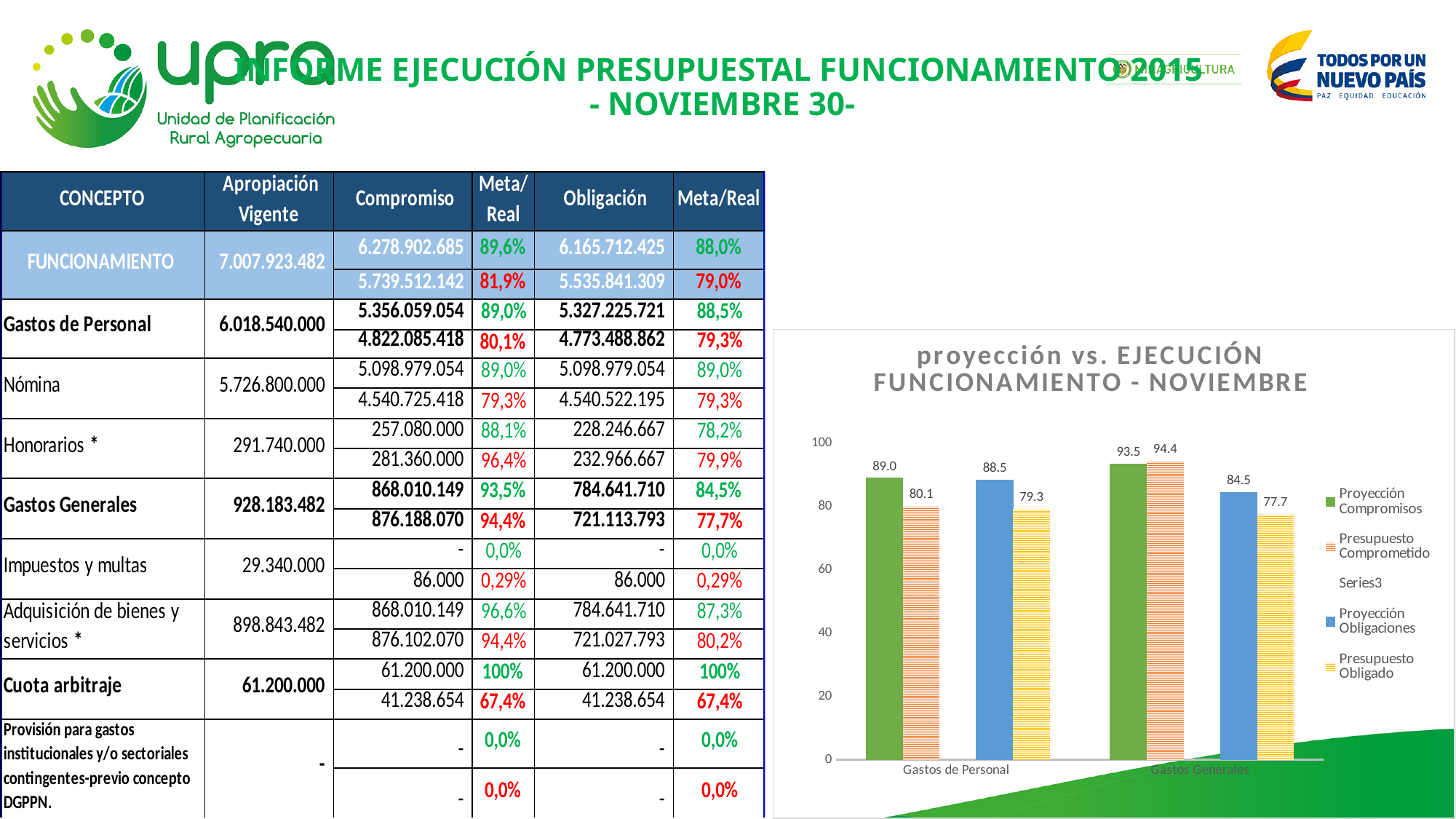
What type of chart is shown on the slide? bar chart What is the value of Presupuesto Comprometido for Gastos Generales? 94.4 What is the title of the chart on the slide? proyección vs. EJECUCIÓN FUNCIONAMIENTO - NOVIEMBRE What is the value of Presupuesto Obligado for Gastos de Personal? 79.3 For Gastos Generales, which is larger: Proyección Compromisos or Presupuesto Comprometido? Presupuesto Comprometido What is the difference between Proyección Obligaciones and Presupuesto Obligado for Gastos de Personal? 9.2 How many categories are shown on the x axis of the chart? 2 What is the value of Proyección Compromisos for Gastos de Personal? 89.0 Which category has the lower Presupuesto Obligado value? Gastos Generales How many series does the chart legend list? 5 Which category has the higher Proyección Compromisos value? Gastos Generales What is the value of Proyección Obligaciones for Gastos Generales? 84.5